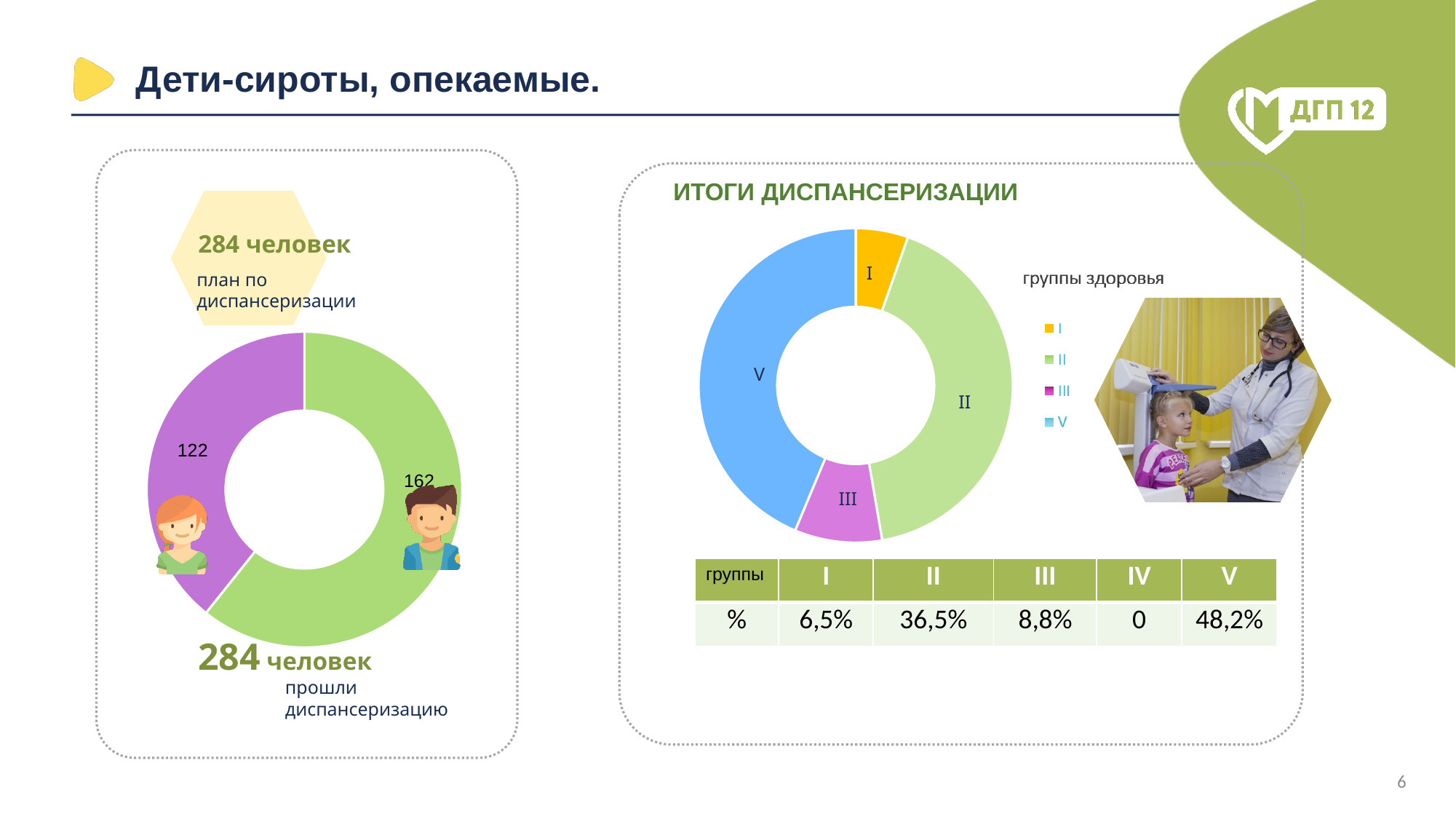
On the chart titled ИТОГИ ДИСПАНСЕРИЗАЦИИ, which health group has the largest share? V On the left donut chart, what is the difference between the green segment (162) and the purple segment (122)? 40 On the chart titled ИТОГИ ДИСПАНСЕРИЗАЦИИ, how many entries does the legend list? 4 On the chart titled ИТОГИ ДИСПАНСЕРИЗАЦИИ, what colour is the segment for health group III? purple On the chart titled ИТОГИ ДИСПАНСЕРИЗАЦИИ, which health group has the smallest share among the plotted segments? I What kind of chart is used on the left side of the slide? donut (pie) chart On the chart titled ИТОГИ ДИСПАНСЕРИЗАЦИИ, what percentage is shown for health group V? 48,2% On the left donut chart, what value is shown for the green segment? 162 On the left donut chart, what is the total of the two segments? 284 On the left donut chart, what value is shown for the purple segment? 122 On the left donut chart, which segment is larger, the purple one or the green one? green On the chart titled ИТОГИ ДИСПАНСЕРИЗАЦИИ, what percentage is shown for health group II? 36,5%